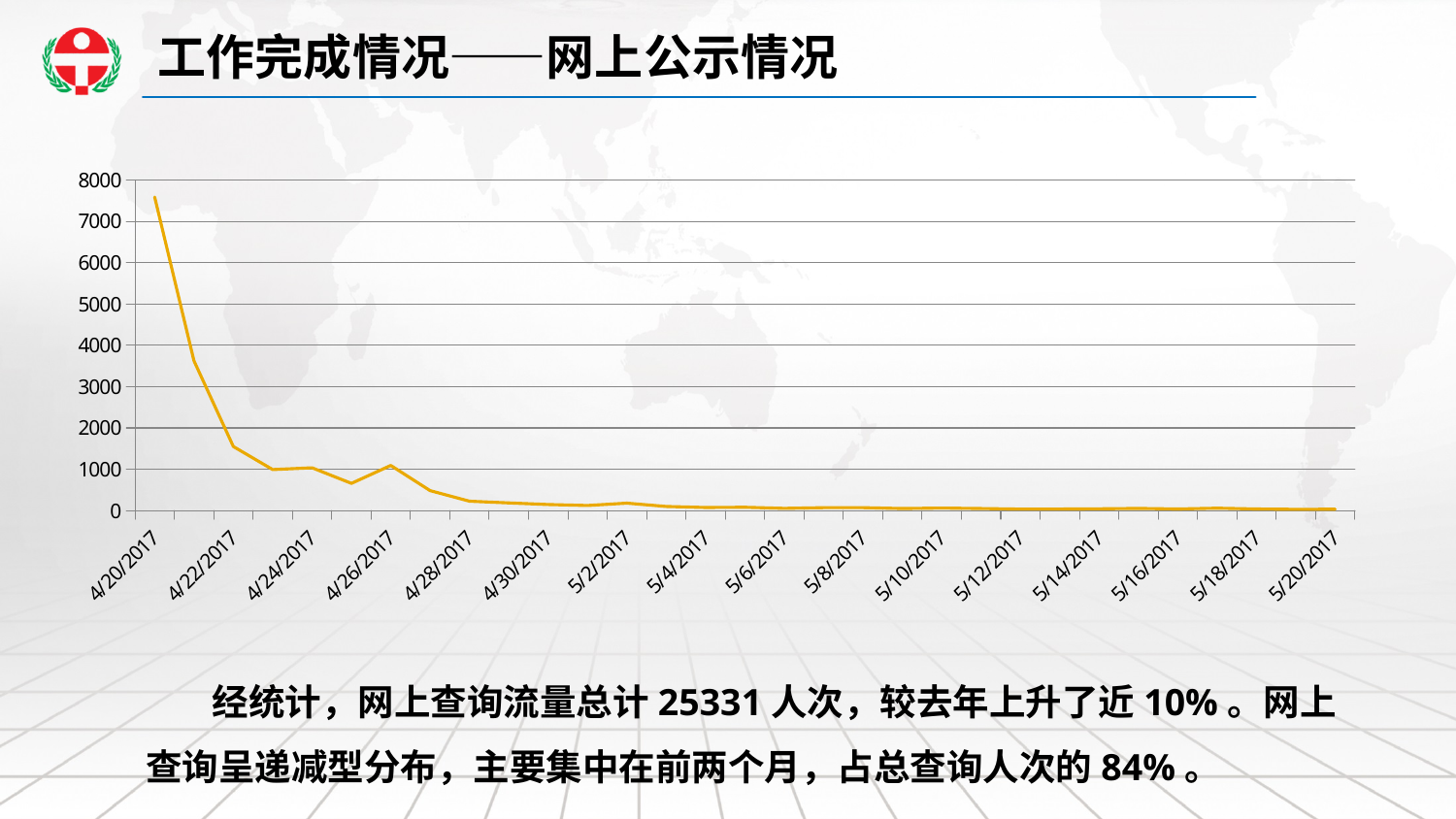
How many date labels are shown on the x axis? 16 Which is larger, the value for 4/20/2017 or the value for 4/22/2017? 4/20/2017 Which is larger, the value for 4/26/2017 or the value for 4/28/2017? 4/26/2017 Which date has the highest value on the chart? 4/20/2017 Is the value for 4/20/2017 greater or less than 7000? greater Is the value for 4/28/2017 greater or less than 1000? less What colour is the line in the chart? orange What is the highest value shown on the y axis? 8000 What kind of chart is shown on the slide? line chart Is the value for 5/20/2017 greater or less than 1000? less Do the values generally rise or fall from left to right along the x axis? fall